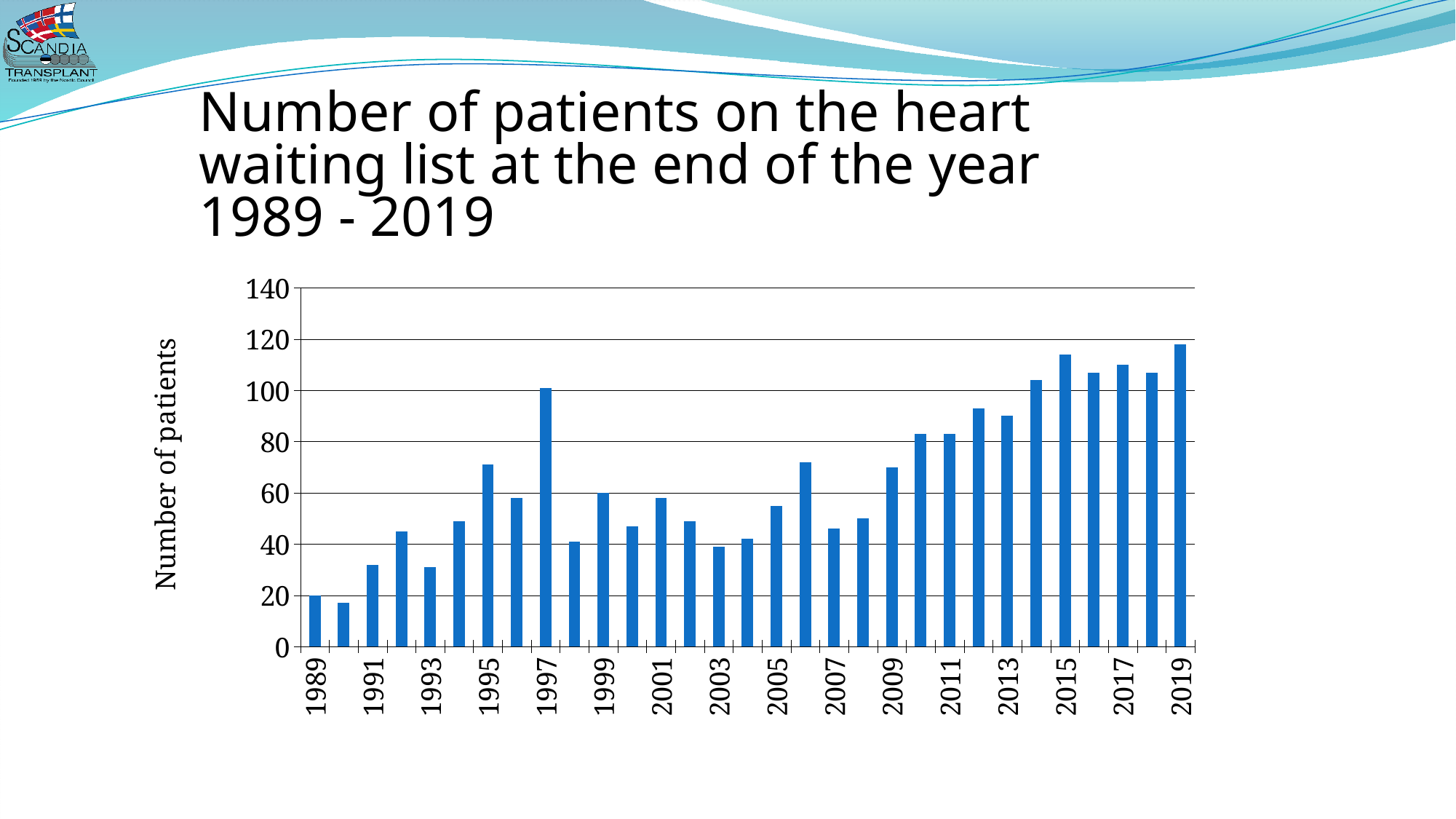
Overall, do the values rise or fall from 1989 to 2019? rise What is the label on the vertical axis of the chart? Number of patients Which year has the highest number of patients on the heart waiting list? 2019 Is the value for 2013 greater or less than 80? greater What kind of chart is shown on the slide? bar chart Is the value for 1989 greater or less than 40? less Is the value for 2019 greater or less than 100? greater Which year has the larger value, 1995 or 1997? 1997 How many years (bars) are plotted in the chart? 31 Which year has the larger value, 2005 or 2006? 2006